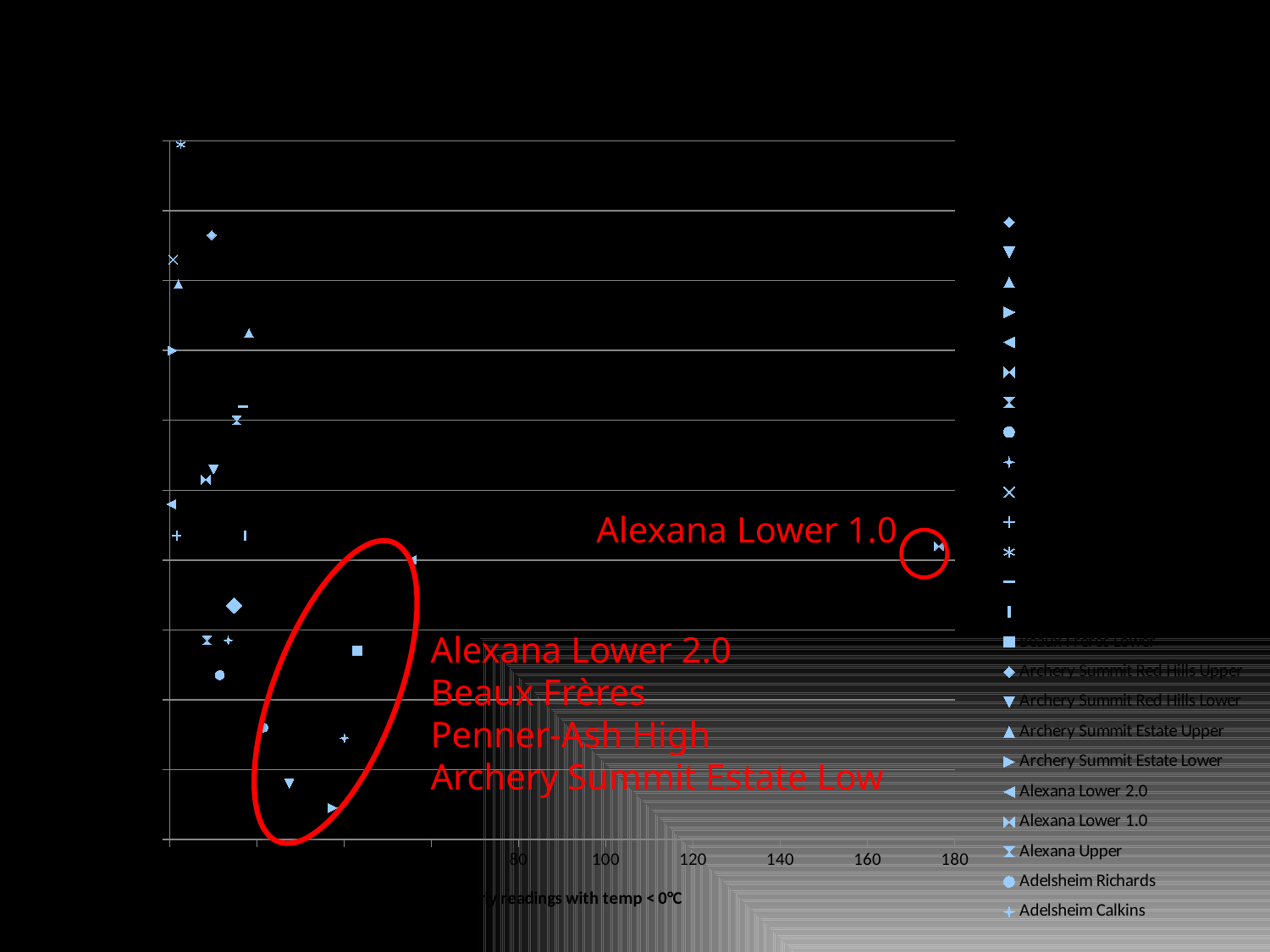
Which legend series uses a circle marker? Adelsheim Richards Which series is circled and labelled in red near the right side of the plot area? Alexana Lower 1.0 What kind of chart is shown on the slide? scatter chart Which series has the point farthest to the right along the x axis? Alexana Lower 1.0 What is the largest tick value shown on the x axis? 180 Is the x-axis value of the circled Alexana Lower 1.0 point greater or less than 160? greater Is the x-axis value of the circled Alexana Lower 1.0 point greater or less than 140? greater Which series is listed last in the legend? Adelsheim Calkins